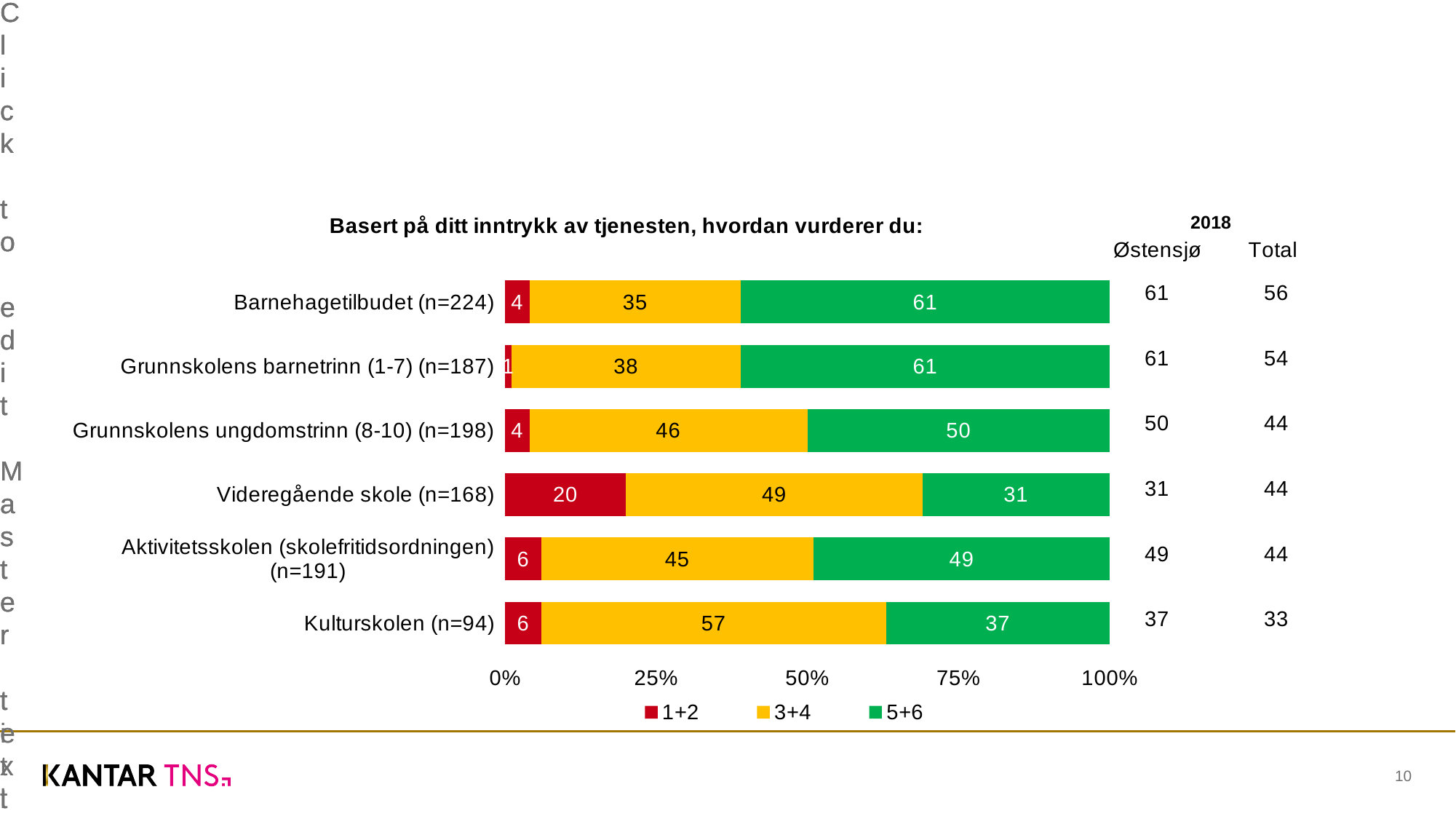
Which category has the highest value in the 1+2 series? Videregående skole (n=168) What is the value of the 5+6 series for Barnehagetilbudet (n=224)? 61 Which category has the lowest value in the 5+6 series? Videregående skole (n=168) What is the title of the chart? Basert på ditt inntrykk av tjenesten, hvordan vurderer du: Which category has the highest value in the 3+4 series? Kulturskolen (n=94) What is the value of the 3+4 series for Kulturskolen (n=94)? 57 What is the difference between the 5+6 values for Grunnskolens ungdomstrinn (8-10) (n=198) and Videregående skole (n=168)? 19 How many categories are shown on the chart? 6 How many series does the legend list? 3 What is the value of the 1+2 series for Videregående skole (n=168)? 20 Which is larger: the 3+4 value for Aktivitetsskolen (skolefritidsordningen) (n=191) or the 3+4 value for Grunnskolens barnetrinn (1-7) (n=187)? Aktivitetsskolen (skolefritidsordningen) (n=191) What kind of chart is shown on the slide? Stacked bar chart